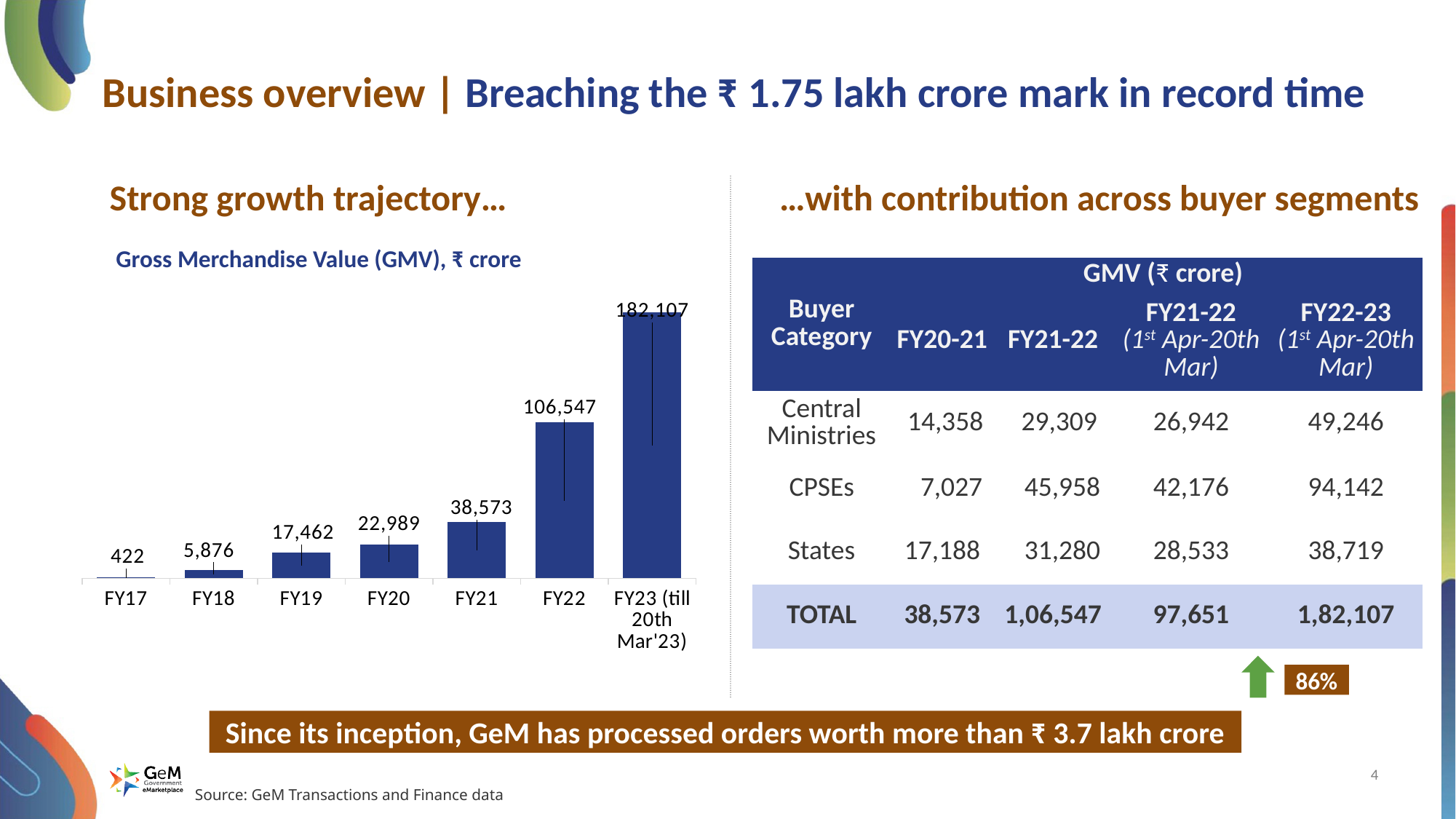
What unit is stated in the title of the Gross Merchandise Value chart? ₹ crore What kind of chart is the Gross Merchandise Value chart? bar chart What is the GMV value for FY20 in the Gross Merchandise Value chart? 22,989 In the Gross Merchandise Value chart, which is larger, the GMV for FY19 or FY20? FY20 Do the GMV values rise or fall from FY17 to FY23 in the Gross Merchandise Value chart? rise Which fiscal year has the highest GMV in the Gross Merchandise Value chart? FY23 (till 20th Mar'23) Which fiscal year has the lowest GMV in the Gross Merchandise Value chart? FY17 What is the GMV value for FY22 in the Gross Merchandise Value chart? 106,547 What is the difference in GMV between FY21 and FY20 in the Gross Merchandise Value chart? 15,584 What is the difference in GMV between FY23 (till 20th Mar'23) and FY22 in the Gross Merchandise Value chart? 75,560 How many fiscal years are plotted in the Gross Merchandise Value chart? 7 What is the GMV value for FY17 in the Gross Merchandise Value chart? 422